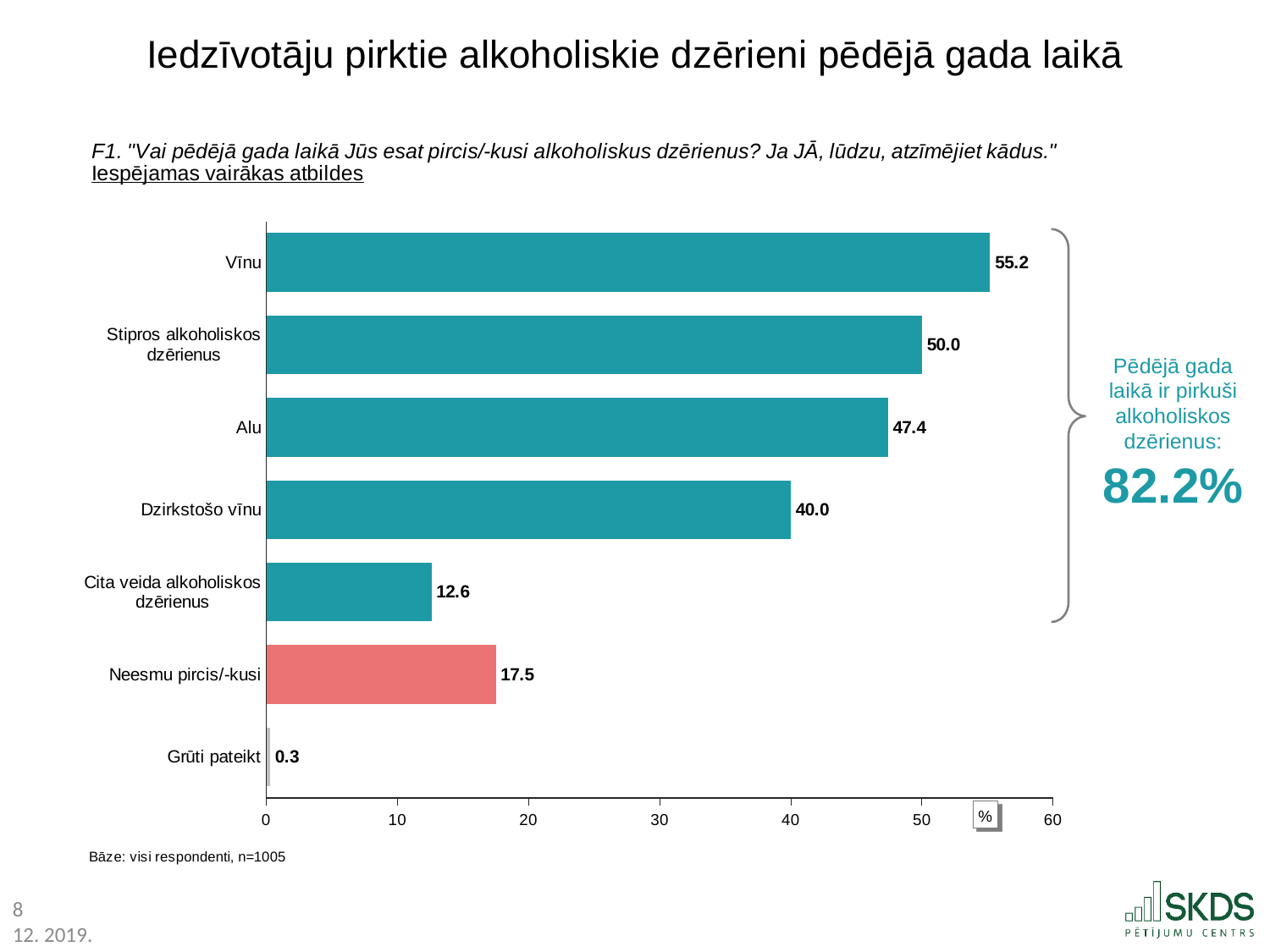
What is the value for Grūti pateikt? 0.3 What percentage is shown next to the bracket as having bought alcoholic drinks in the last year? 82.2% What is the difference between the values for Vīnu and Dzirkstošo vīnu? 15.2 Which category has the lowest value? Grūti pateikt What is the value for Alu? 47.4 What is the value for Vīnu? 55.2 What is the value for Neesmu pircis/-kusi? 17.5 What kind of chart is shown on the slide? Bar chart How many categories are shown in the chart? 7 Which is larger, the value for Stipros alkoholiskos dzērienus or the value for Alu? Stipros alkoholiskos dzērienus Which category has the highest value? Vīnu What is the difference between the values for Neesmu pircis/-kusi and Cita veida alkoholiskos dzērienus? 4.9